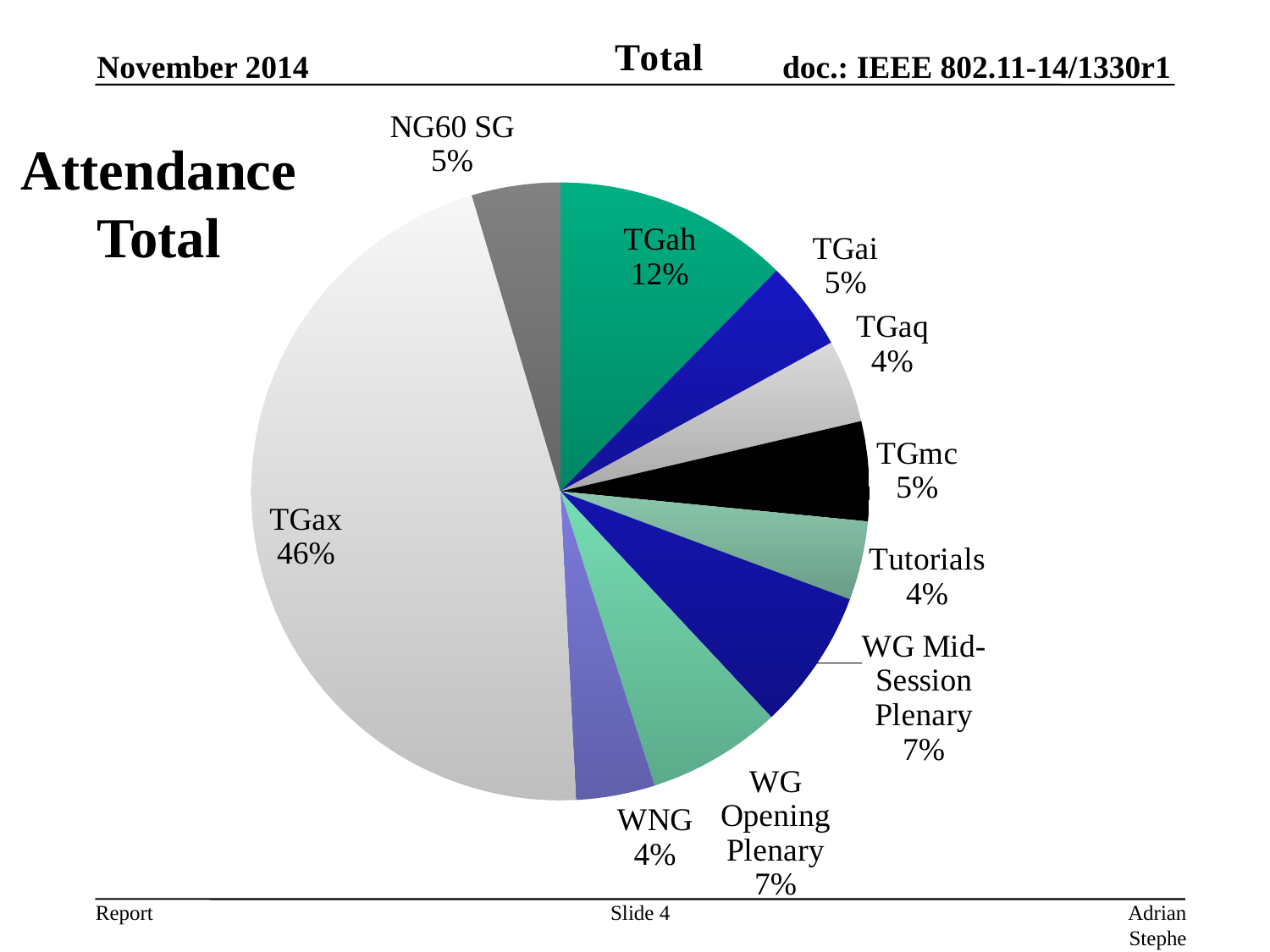
Which is larger, the slice for TGah or the slice for TGmc? TGah What is the value shown for Tutorials? 4% What is the title of the chart? Total How many slices does the pie chart have? 10 What kind of chart is shown on the slide? pie chart What share of the pie does TGah have? 12% What is the value shown for NG60 SG? 5% Which category has the largest slice of the pie? TGax What is the difference between the WG Opening Plenary share and the WNG share? 3% What is the value shown for WG Mid-Session Plenary? 7% What is the difference between the TGax share and the TGah share? 34% What share of the pie does TGax have? 46%